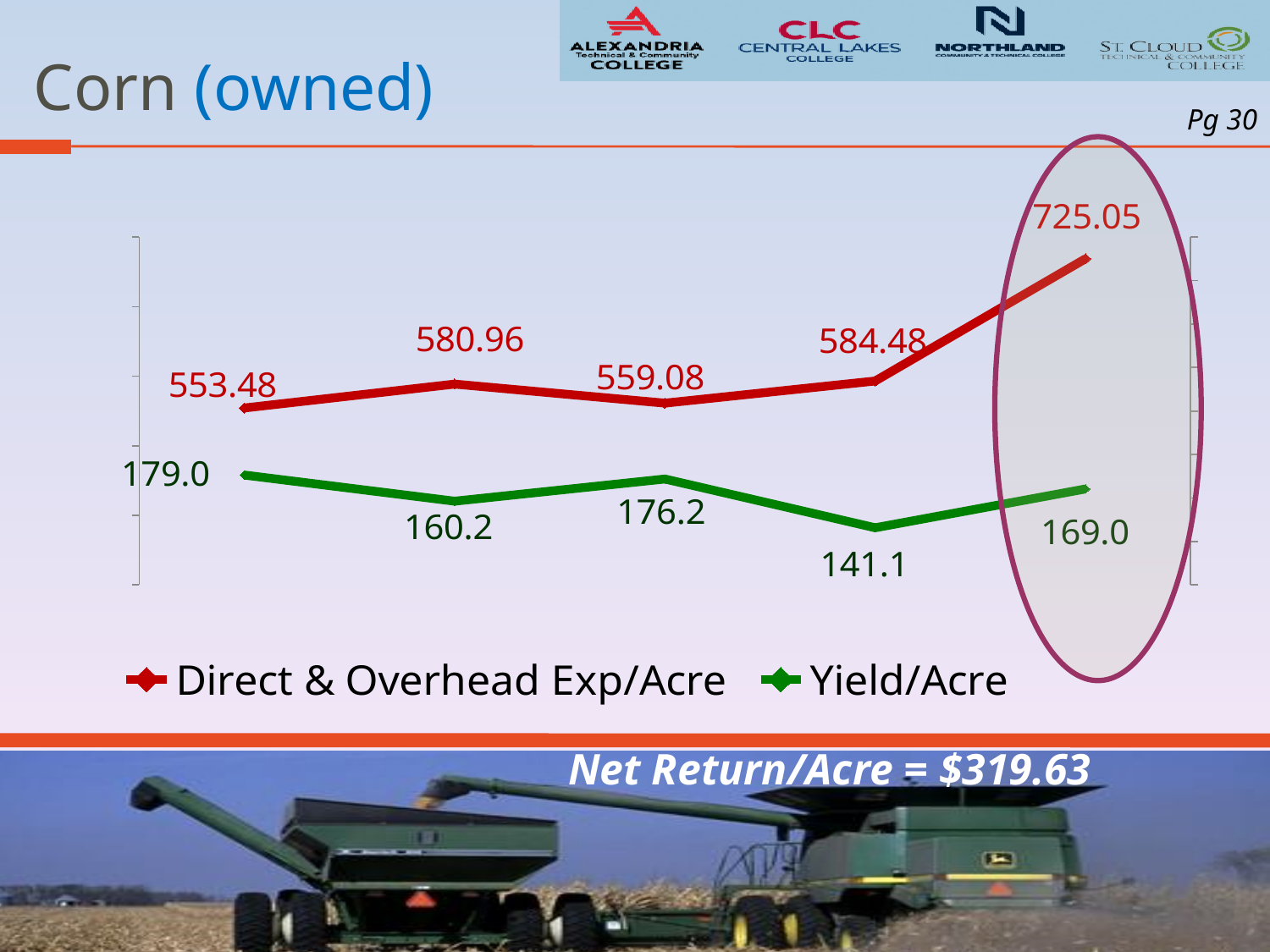
What is the difference between the highest and lowest Yield/Acre values, 179.0 and 141.1? 37.9 What is the lowest value shown for the Yield/Acre series? 141.1 How many data points are plotted for the Direct & Overhead Exp/Acre series? 5 How many series does the legend list? 2 What kind of chart is shown on the slide? line chart What is the highest value shown for the Yield/Acre series? 179.0 Which is larger for Direct & Overhead Exp/Acre: the second point (580.96) or the third point (559.08)? 580.96 What is the last (rightmost) value of the Direct & Overhead Exp/Acre series? 725.05 What colour is the Yield/Acre line? green What is the first (leftmost) value of the Yield/Acre series? 179.0 What is the highest value shown for the Direct & Overhead Exp/Acre series? 725.05 What is the difference between the last two values of the Direct & Overhead Exp/Acre series, 725.05 and 584.48? 140.57